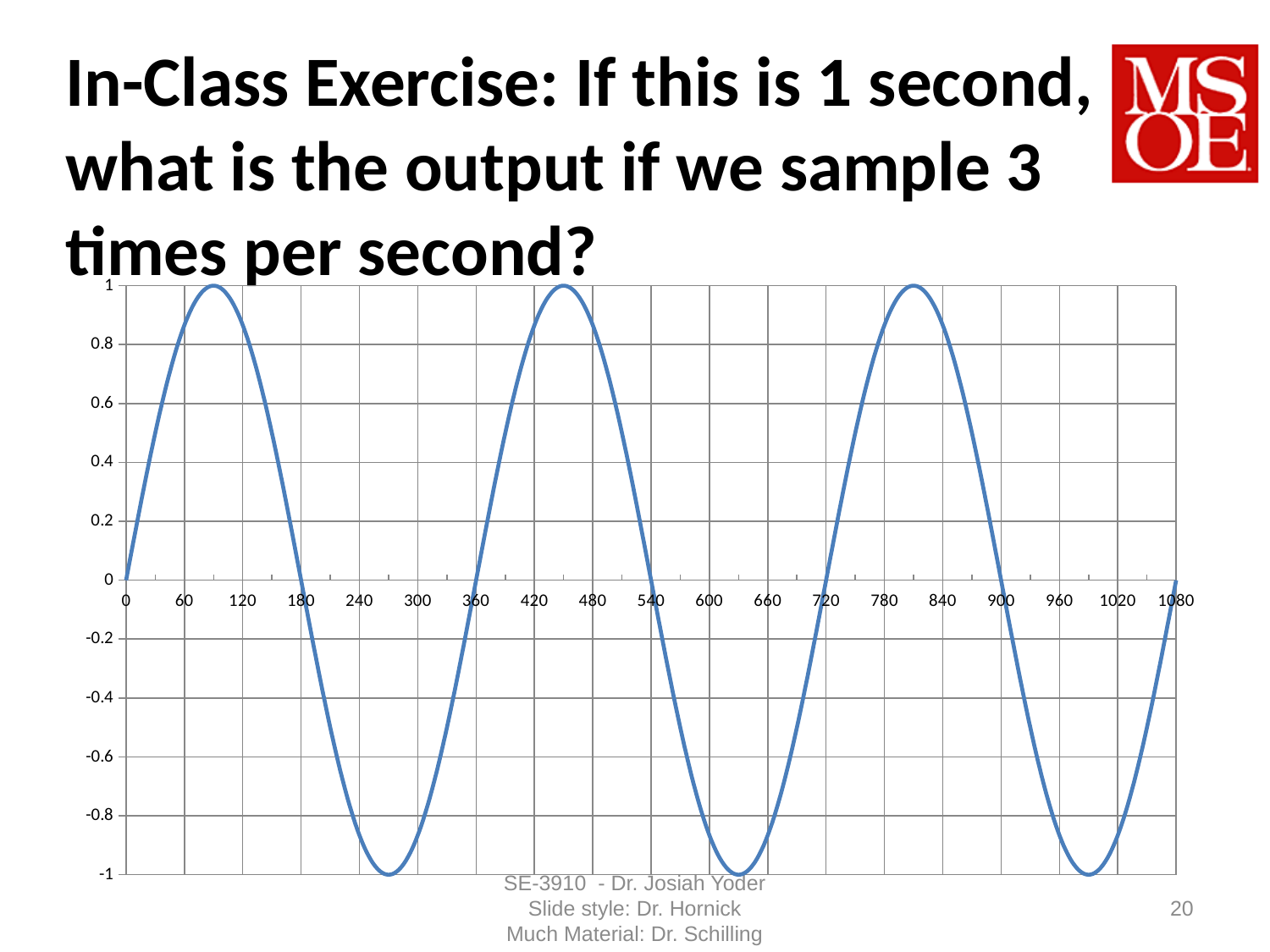
What is the lowest value the curve reaches? -1 What is the value of the curve at x = 90? 1 What is the value of the curve at x = 270? -1 What is the highest value the curve reaches? 1 What is the value of the curve at x = 360? 0 Is the value of the curve at x = 60 greater or less than 0.6? greater How many complete cycles of the wave are plotted between x = 0 and x = 1080? 3 Which is larger, the value at x = 90 or the value at x = 270? x = 90 Does the curve rise or fall between x = 0 and x = 90? rise Is the value of the curve at x = 240 greater or less than -0.6? less What kind of chart is shown on the slide? line chart What is the largest value labelled on the x axis? 1080